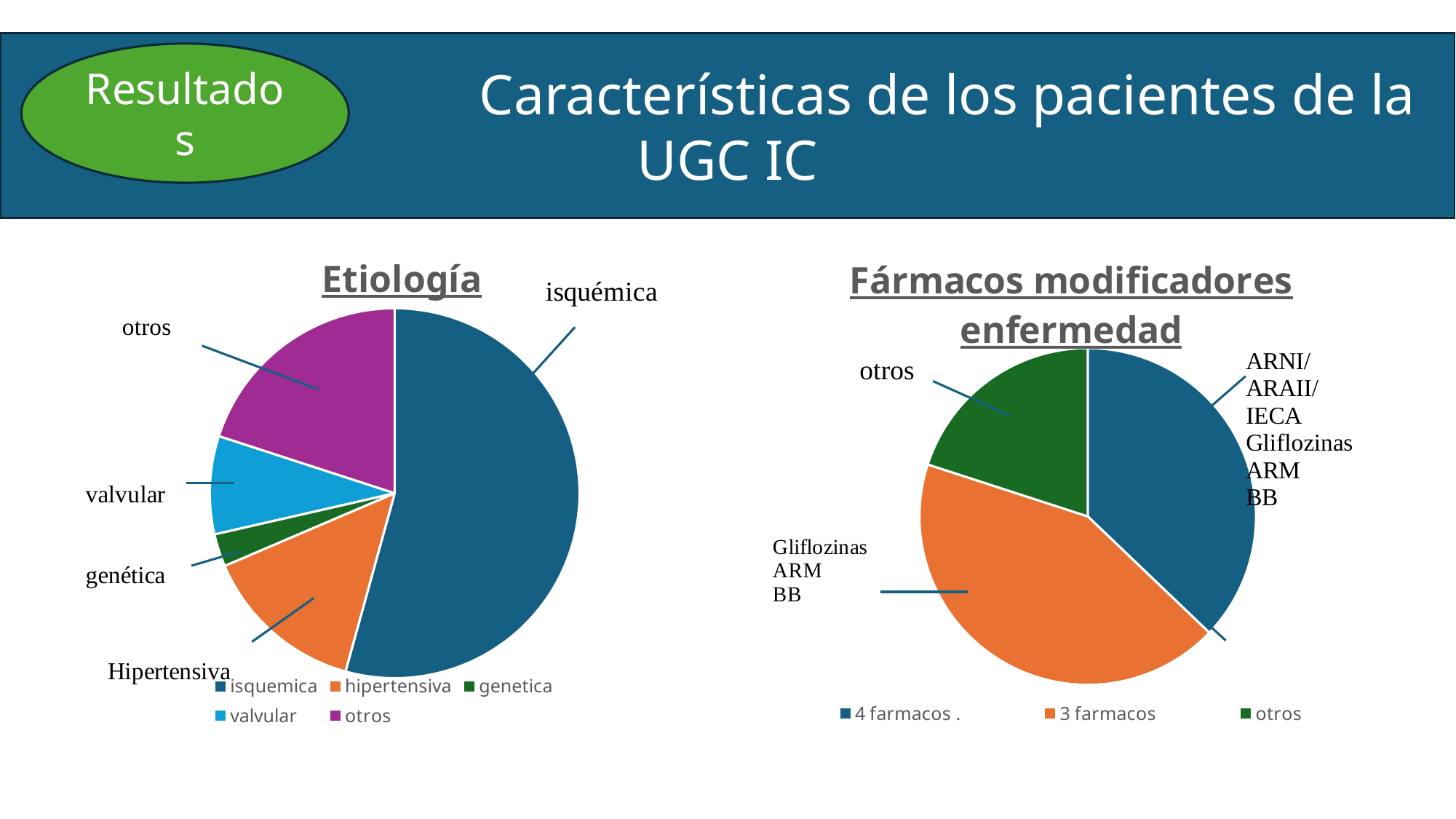
In the Etiología chart, how many slices does the pie have? 5 In the Fármacos modificadores enfermedad chart, how many entries does the legend list? 3 What kind of chart is the Fármacos modificadores enfermedad chart? pie chart In the Fármacos modificadores enfermedad chart, which category has the smallest slice? otros In the Fármacos modificadores enfermedad chart, how many slices does the pie have? 3 In the Etiología chart, how many entries does the legend list? 5 In the Etiología chart, which category has the smallest slice? genetica In the Etiología chart, which slice is larger, hipertensiva or genetica? hipertensiva In the Etiología chart, which slice is larger, otros or valvular? otros In the Etiología chart, which category has the largest slice? isquemica In the Fármacos modificadores enfermedad chart, what colour is the 3 farmacos slice? orange What kind of chart is the Etiología chart? pie chart